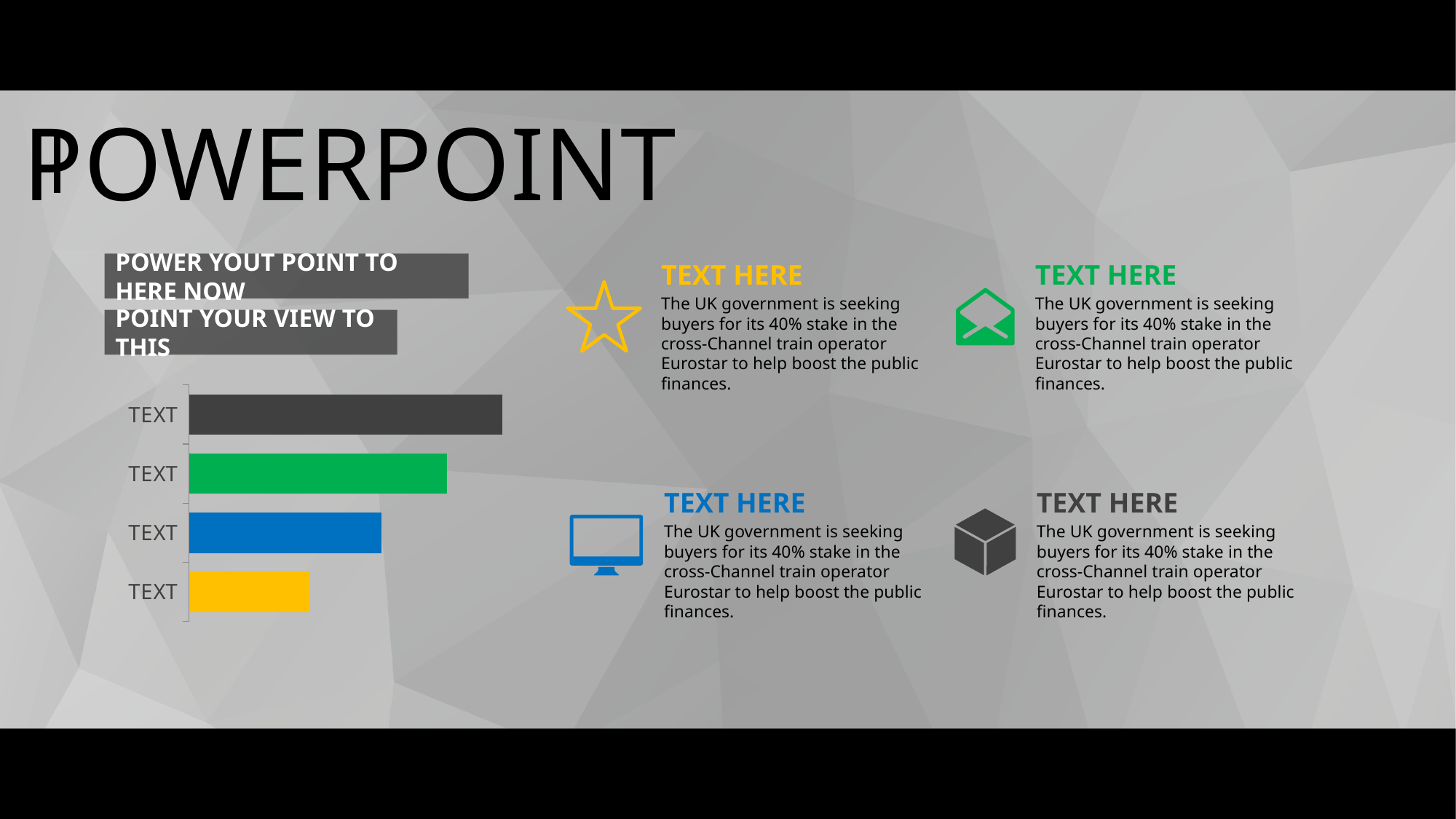
In the bar chart, is the green bar longer or shorter than the blue bar? longer How many bars does the bar chart on the left of the slide have? 4 What label is shown for each category on the vertical axis of the bar chart? TEXT Do the bars in the bar chart get longer or shorter going from the top bar to the bottom bar? shorter Which bar in the bar chart is the shortest: the dark grey, green, blue or yellow one? yellow Which bar in the bar chart is the longest: the dark grey, green, blue or yellow one? dark grey What colour is the top bar in the bar chart? dark grey What kind of chart is shown on the left of the slide? bar chart In the bar chart, is the yellow bar longer or shorter than the dark grey bar? shorter In the bar chart, is the blue bar longer or shorter than the yellow bar? longer